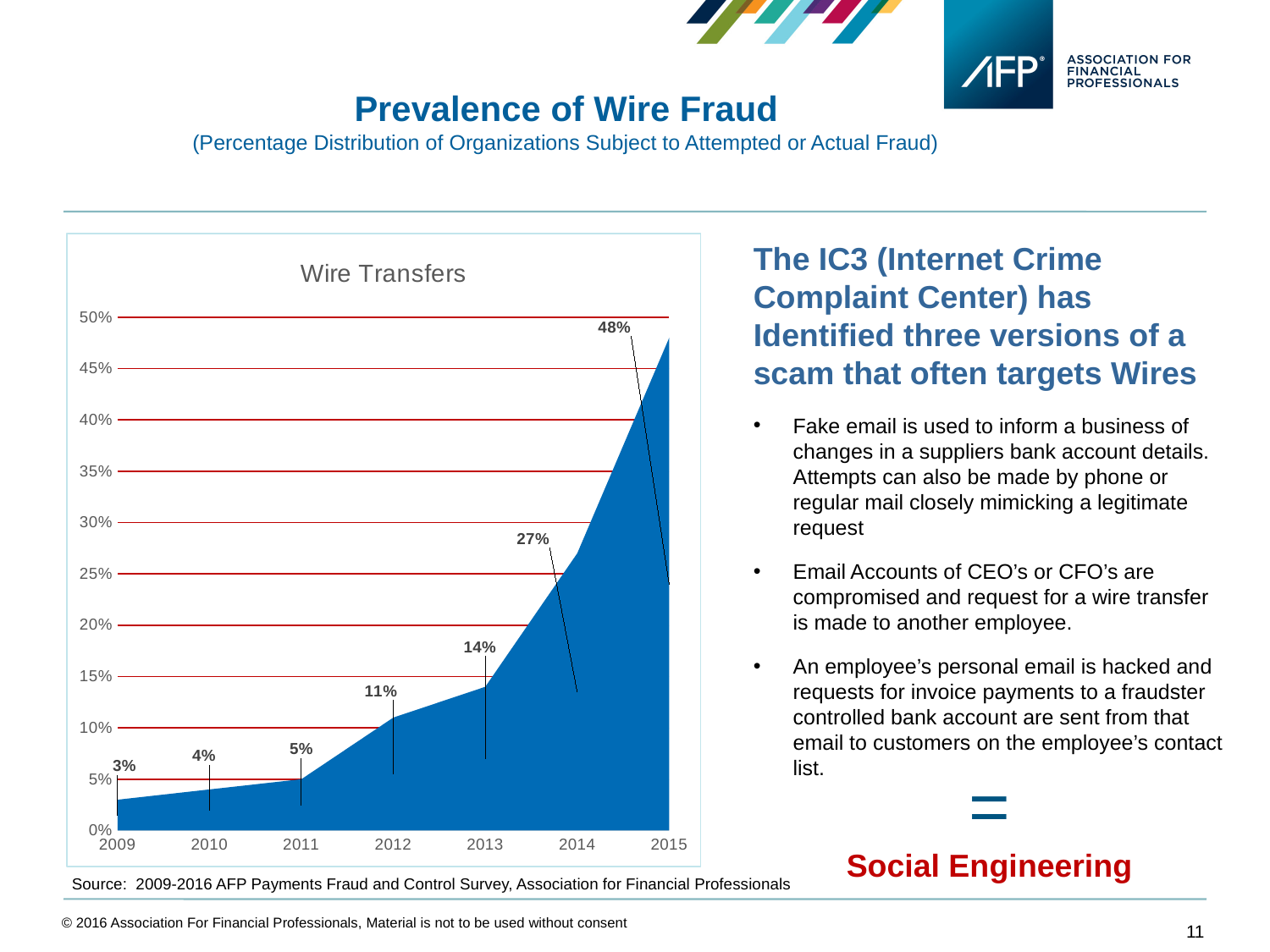
What is the value for 2015 in the Wire Transfers chart? 48% What is the title of the chart on the slide? Wire Transfers What is the difference between the 2013 and 2012 values in the Wire Transfers chart? 3% Which year has a larger value in the Wire Transfers chart, 2011 or 2013? 2013 Which year has the lowest value in the Wire Transfers chart? 2009 Do the values in the Wire Transfers chart rise or fall from 2009 to 2015? Rise What is the value for 2012 in the Wire Transfers chart? 11% What kind of chart is the Wire Transfers chart? Area chart How many years are plotted in the Wire Transfers chart? 7 Which year has the highest value in the Wire Transfers chart? 2015 What is the value for 2009 in the Wire Transfers chart? 3% What is the difference between the 2015 and 2014 values in the Wire Transfers chart? 21%